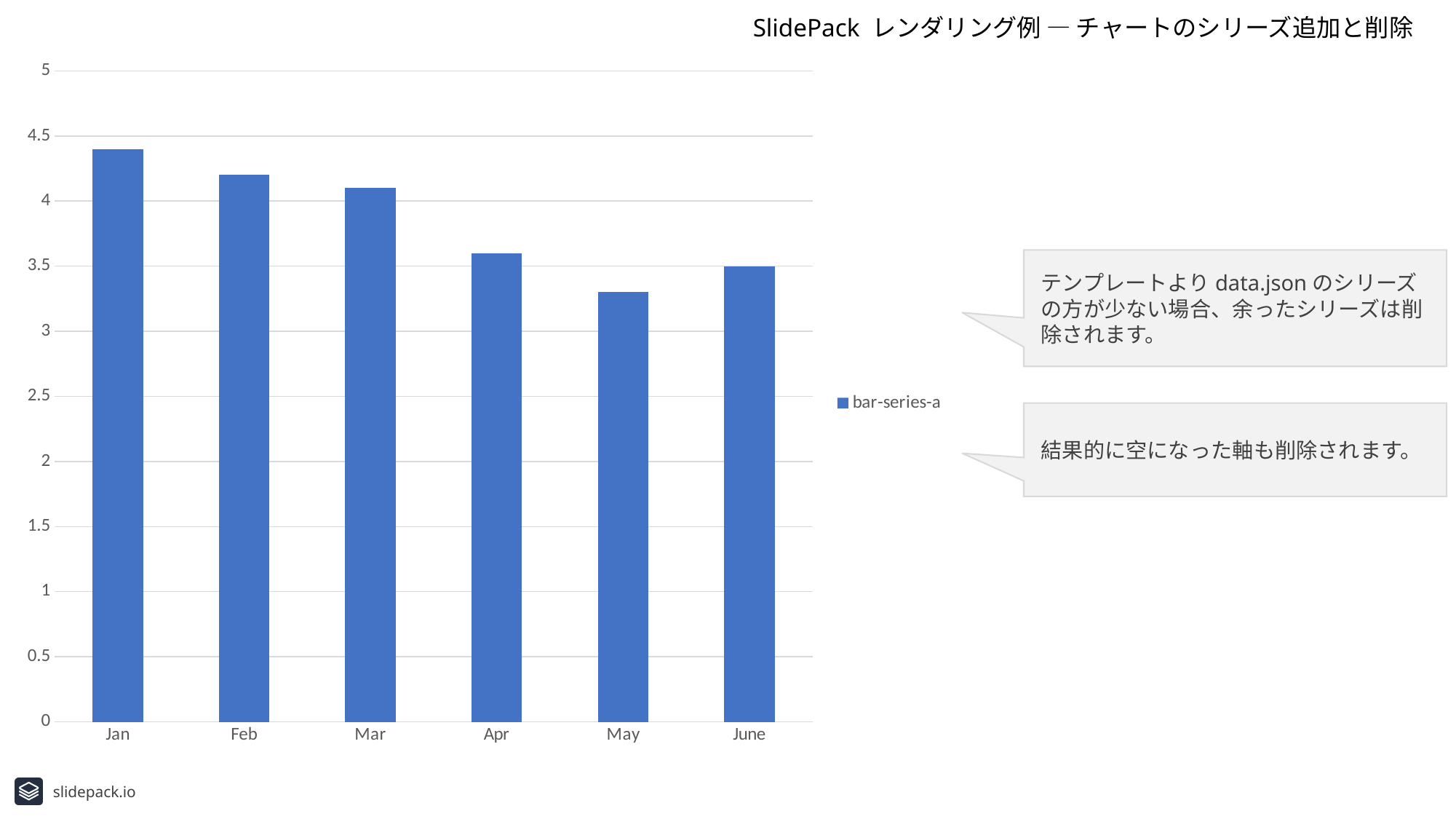
What kind of chart is shown on the slide? bar chart Is the value for Jan greater or less than 4? greater How many series does the chart's legend list? 1 Is the value for Apr greater or less than 4? less Which month has the highest value in the chart? Jan Is the value for Feb greater or less than 4? greater Which month has the lowest value in the chart? May How many categories are shown on the x axis of the chart? 6 Which is larger, the value for Jan or the value for Apr? Jan Do the values rise or fall from Jan to May? fall What is the name of the series listed in the chart's legend? bar-series-a